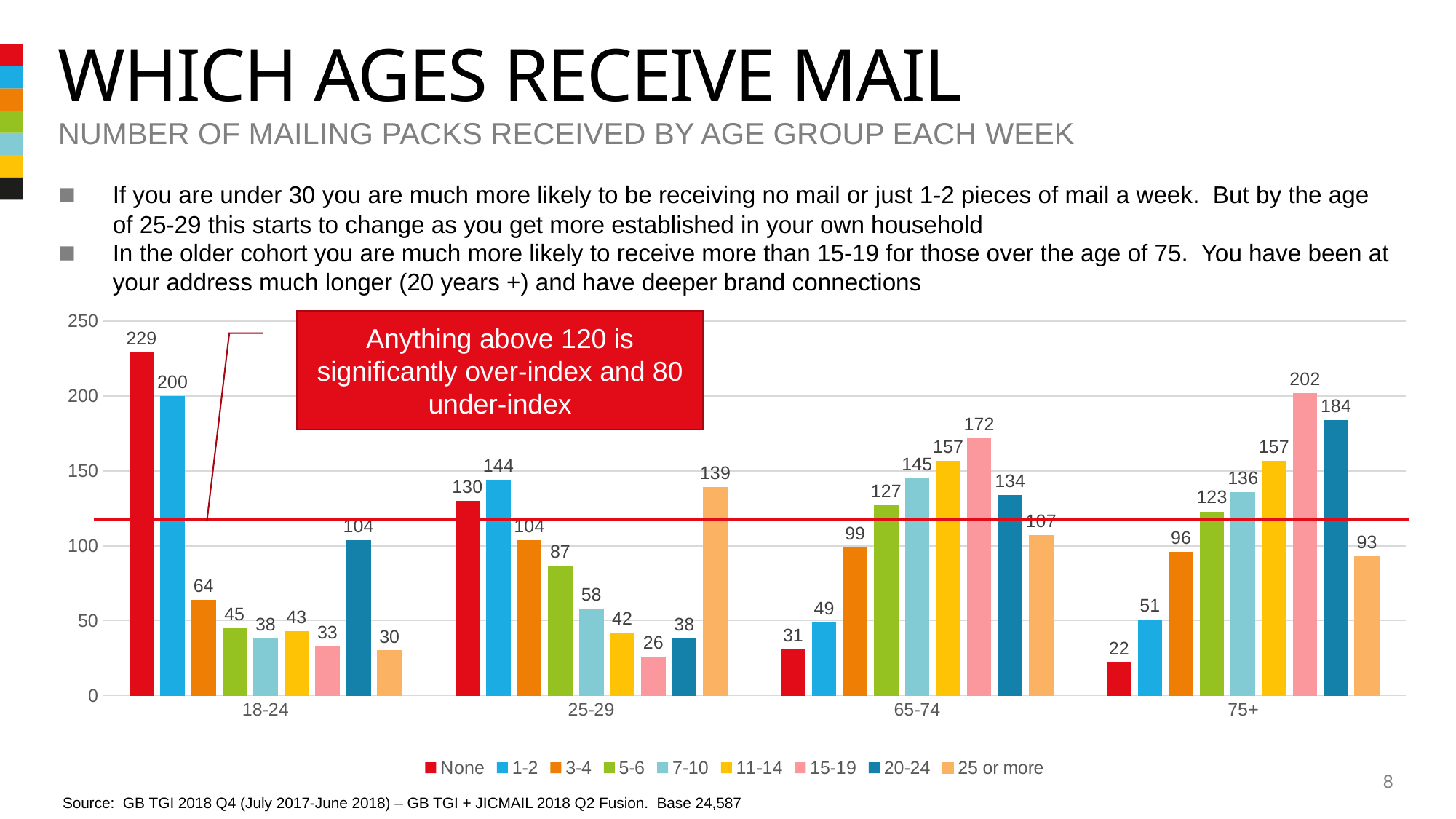
Which series has the highest value in the 65-74 age group? 15-19 Which is larger: the '20-24' value for 65-74 or the '20-24' value for 75+? 75+ How many series does the legend list? 9 Which series has the lowest value in the 75+ age group? None What is the value for '7-10' in the 65-74 age group? 145 What is the value for '25 or more' in the 25-29 age group? 139 What kind of chart is shown on the slide? Bar chart What is the value for '15-19' in the 75+ age group? 202 How many age groups are shown on the x axis? 4 According to the red callout box, above what value is something significantly over-index? 120 What is the value for 'None' in the 18-24 age group? 229 What is the difference between the 'None' value for 18-24 and the 'None' value for 75+? 207